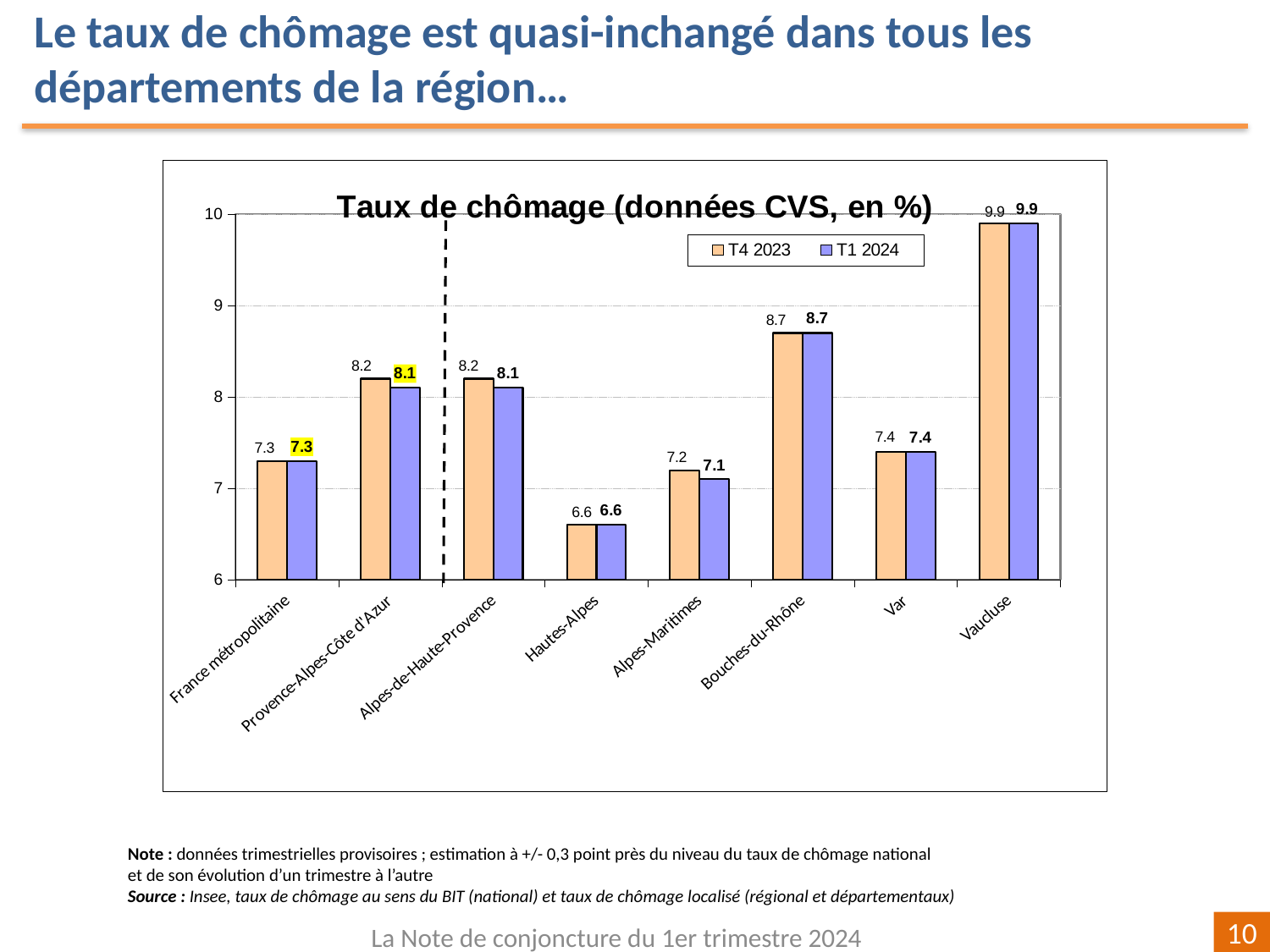
What is the difference between the T1 2024 rates of Bouches-du-Rhône and Var? 1.3 What is the T1 2024 unemployment rate for Vaucluse? 9.9 What is the T4 2023 unemployment rate for Alpes-Maritimes? 7.2 How many series does the legend list? 2 What is the title of the chart? Taux de chômage (données CVS, en %) How many categories are shown on the x axis? 8 Which category has the lowest T4 2023 unemployment rate? Hautes-Alpes Is the T1 2024 value for Hautes-Alpes greater or less than 7? less What kind of chart is shown? bar chart Which is larger, the T4 2023 rate for Alpes-de-Haute-Provence or for Alpes-Maritimes? Alpes-de-Haute-Provence What is the T1 2024 value for Provence-Alpes-Côte d'Azur? 8.1 Which category has the highest T1 2024 unemployment rate? Vaucluse